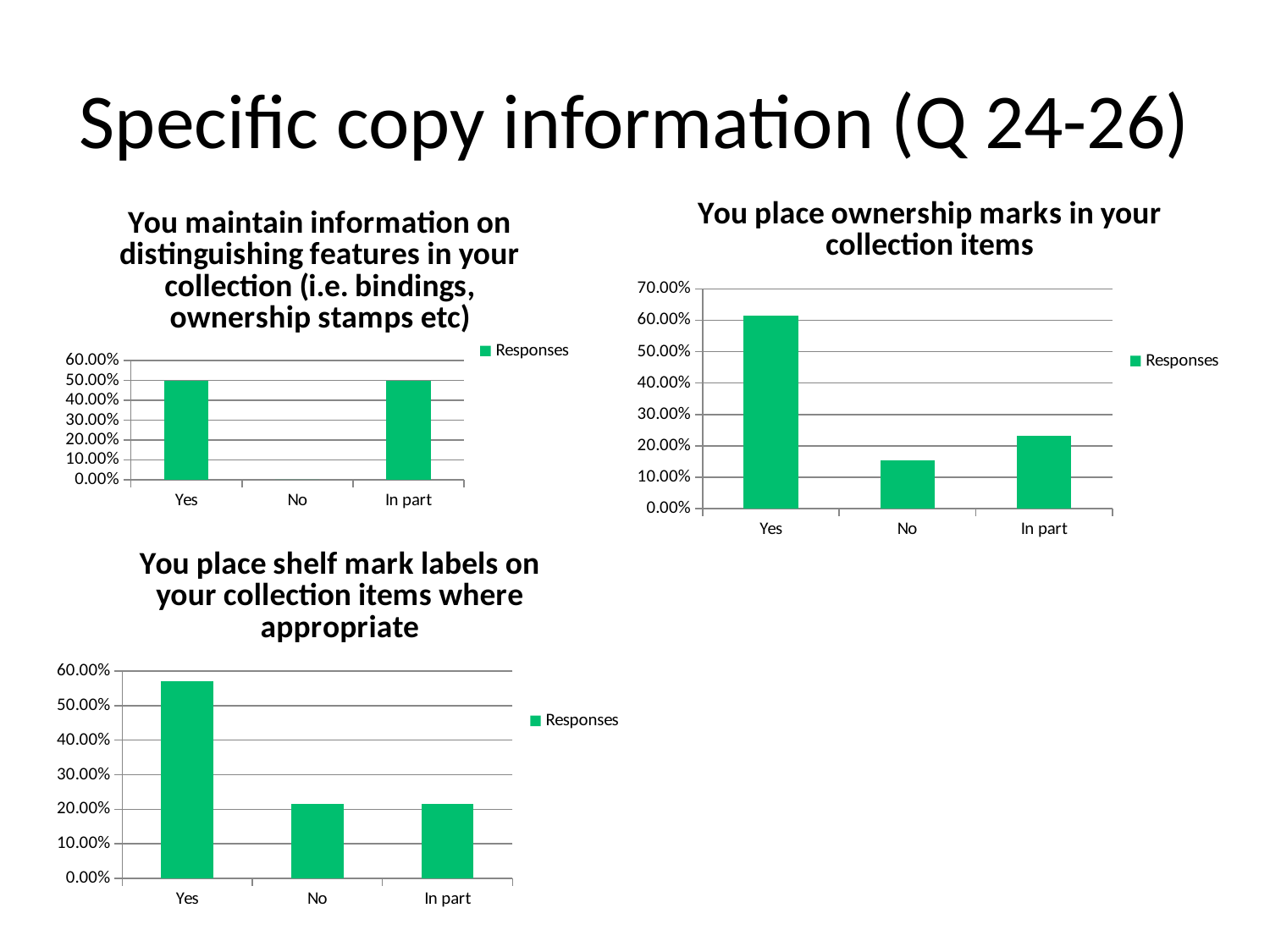
In the chart titled "You maintain information on distinguishing features in your collection", what is the value for Yes? 50.00% In the chart titled "You place ownership marks in your collection items", is the value for No greater or less than 20.00%? less What kind of chart is the chart titled "You place shelf mark labels on your collection items where appropriate"? Bar chart In the chart titled "You place ownership marks in your collection items", which is larger, the value for No or the value for In part? In part In the chart titled "You place ownership marks in your collection items", is the value for Yes greater or less than 50.00%? greater How many categories are shown on the x axis of the chart titled "You place ownership marks in your collection items"? 3 In the chart titled "You place ownership marks in your collection items", which category has the lowest value? No In the chart titled "You maintain information on distinguishing features in your collection", which category has the lowest value? No In the chart titled "You place shelf mark labels on your collection items where appropriate", is the value for No greater or less than 30.00%? less In the chart titled "You place ownership marks in your collection items", which category has the highest value? Yes In the chart titled "You place shelf mark labels on your collection items where appropriate", which category has the highest value? Yes